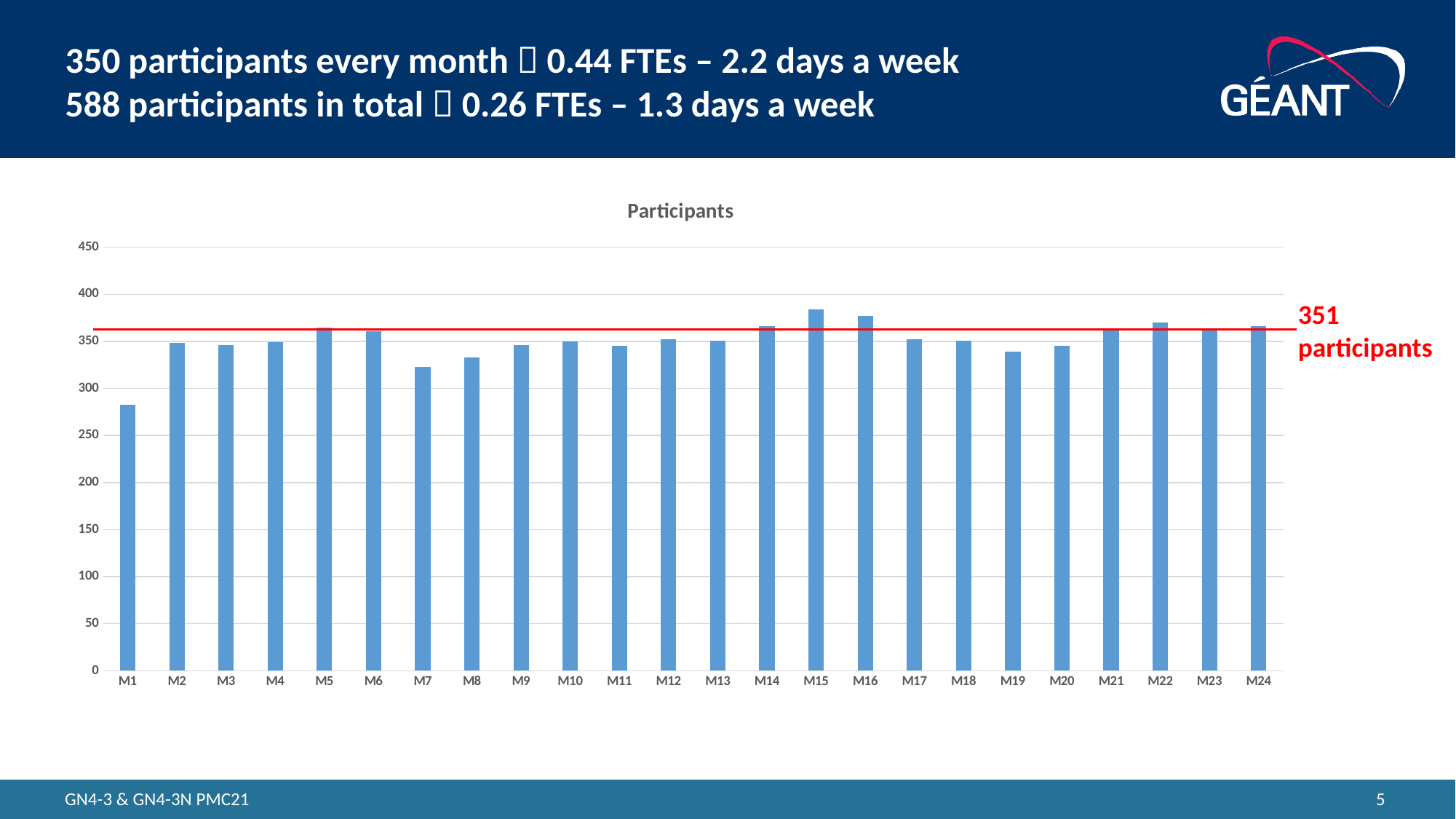
Is the value for M7 greater or less than 350? less Is the value for M16 greater or less than 350? greater What value does the red horizontal line across the chart represent, according to its label? 351 participants What kind of chart is shown on the slide? bar chart Which has more participants, M15 or M1? M15 How many months (categories) are plotted on the x axis of the Participants chart? 24 Is the value for M1 greater or less than 300? less What is the title of the chart? Participants Which has more participants, M7 or M8? M8 Which month has the highest number of participants in the chart? M15 Which month has the lowest number of participants in the chart? M1